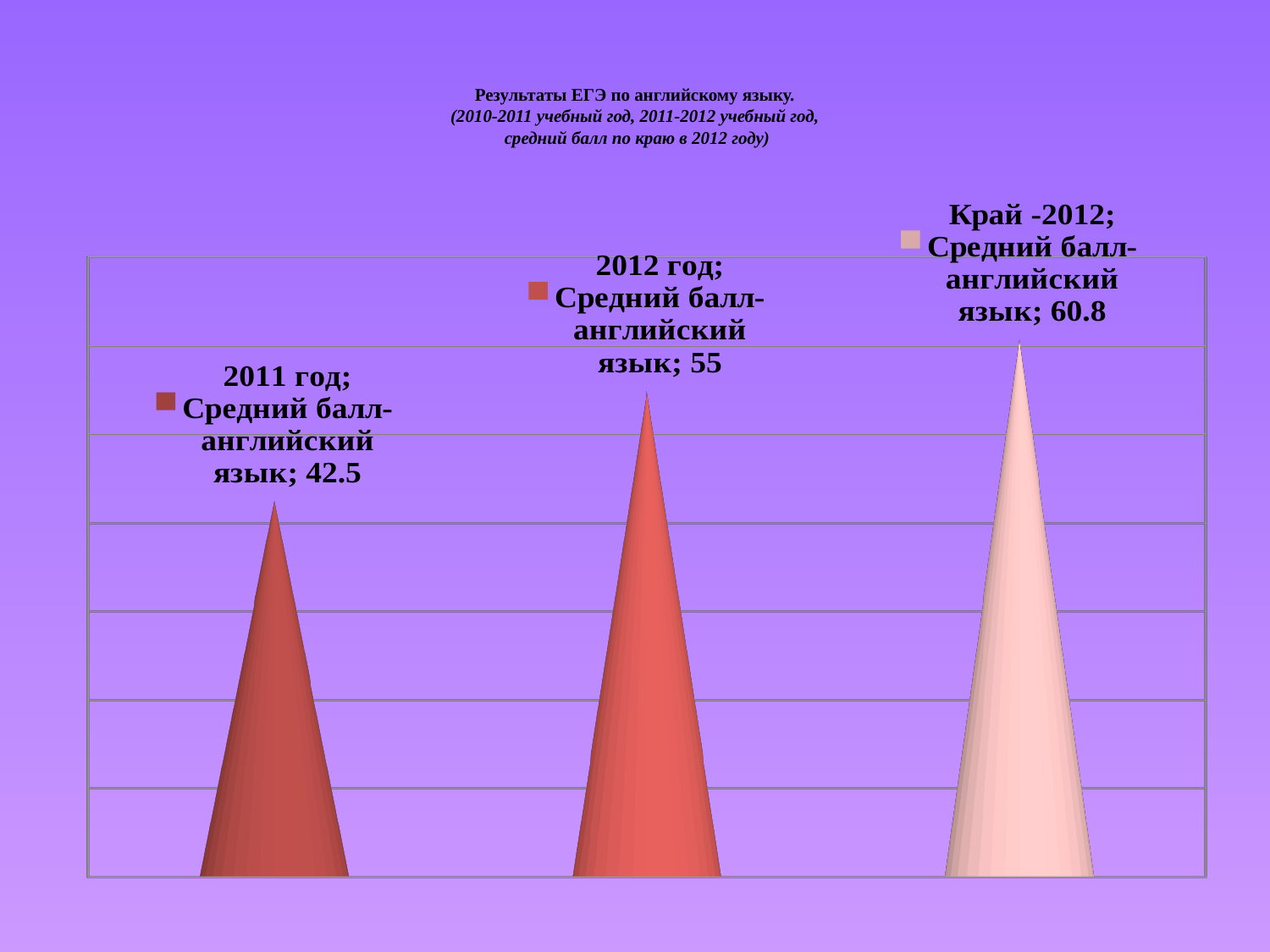
What is the value shown for Край -2012? 60.8 Which category has the lowest value? 2011 год What is the difference between the values for 2012 год and 2011 год? 12.5 What is the average English score shown for 2012 год? 55 Which category has the highest value? Край -2012 Do the values rise or fall from left to right across the chart? Rise What kind of chart is shown on the slide? Bar chart What is the first line of the chart title? Результаты ЕГЭ по английскому языку. What is the average English score shown for 2011 год? 42.5 How many categories are plotted on the chart? 3 Which is larger, the value for 2011 год or the value for 2012 год? 2012 год What is the difference between the values for Край -2012 and 2012 год? 5.8